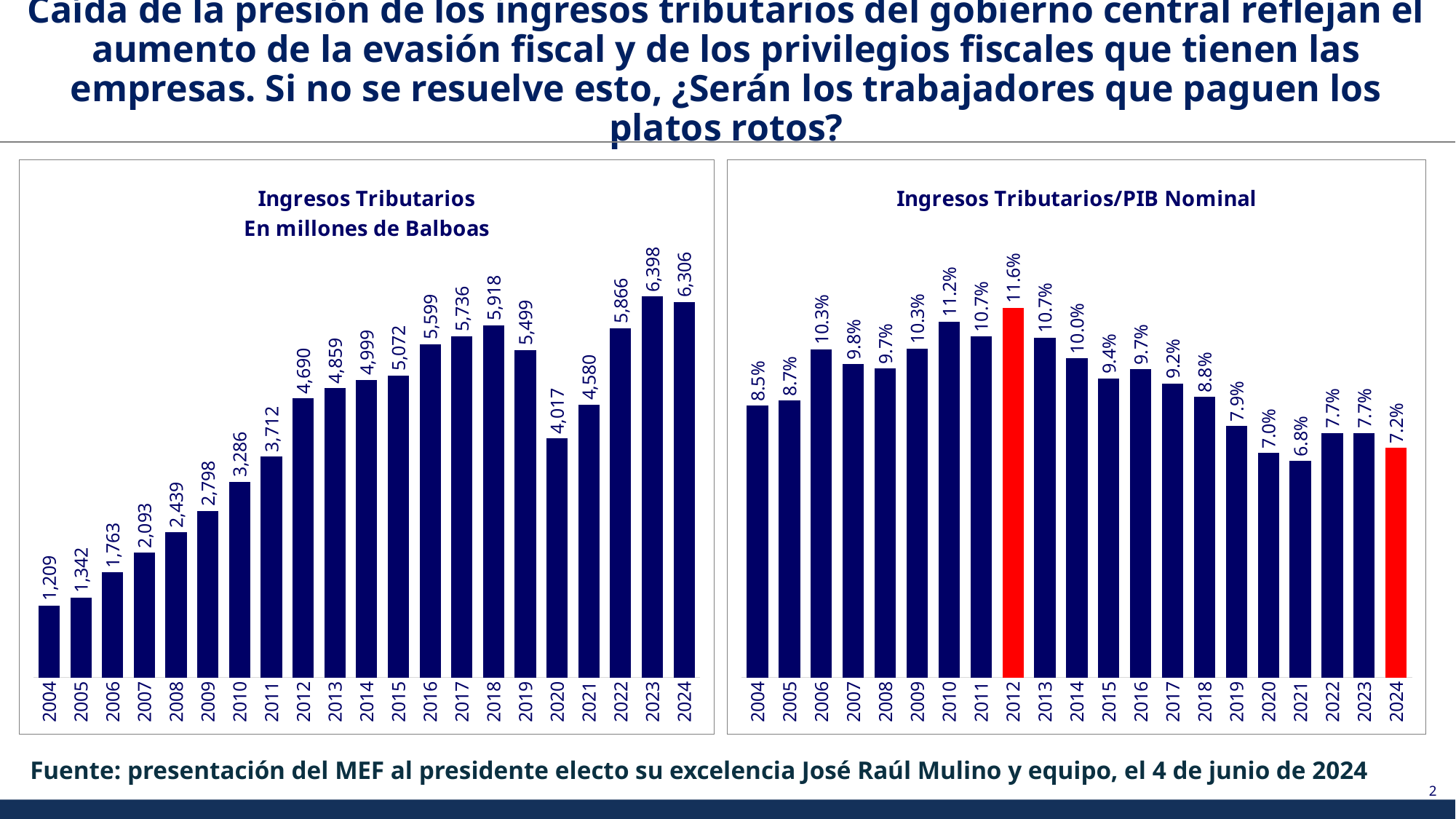
In the 'Ingresos Tributarios/PIB Nominal' chart, which is larger, the value for 2010 or the value for 2014? 2010 In the 'Ingresos Tributarios/PIB Nominal' chart, what is the value for 2012? 11.6% In the 'Ingresos Tributarios' chart, which year has the lowest value? 2004 In the 'Ingresos Tributarios' chart, what is the value for 2020? 4,017 In the 'Ingresos Tributarios' chart, how many years are shown? 21 In the 'Ingresos Tributarios' chart, which year has the highest value? 2023 In the 'Ingresos Tributarios/PIB Nominal' chart, which two years have bars coloured red? 2012 and 2024 In the 'Ingresos Tributarios/PIB Nominal' chart, which year has the lowest value? 2021 What kind of chart is the 'Ingresos Tributarios/PIB Nominal' chart? Bar chart In the 'Ingresos Tributarios' chart, what is the difference between the values for 2023 and 2024? 92 In the 'Ingresos Tributarios/PIB Nominal' chart, what is the value for 2004? 8.5% In the 'Ingresos Tributarios/PIB Nominal' chart, what is the difference between the values for 2012 and 2024? 4.4%